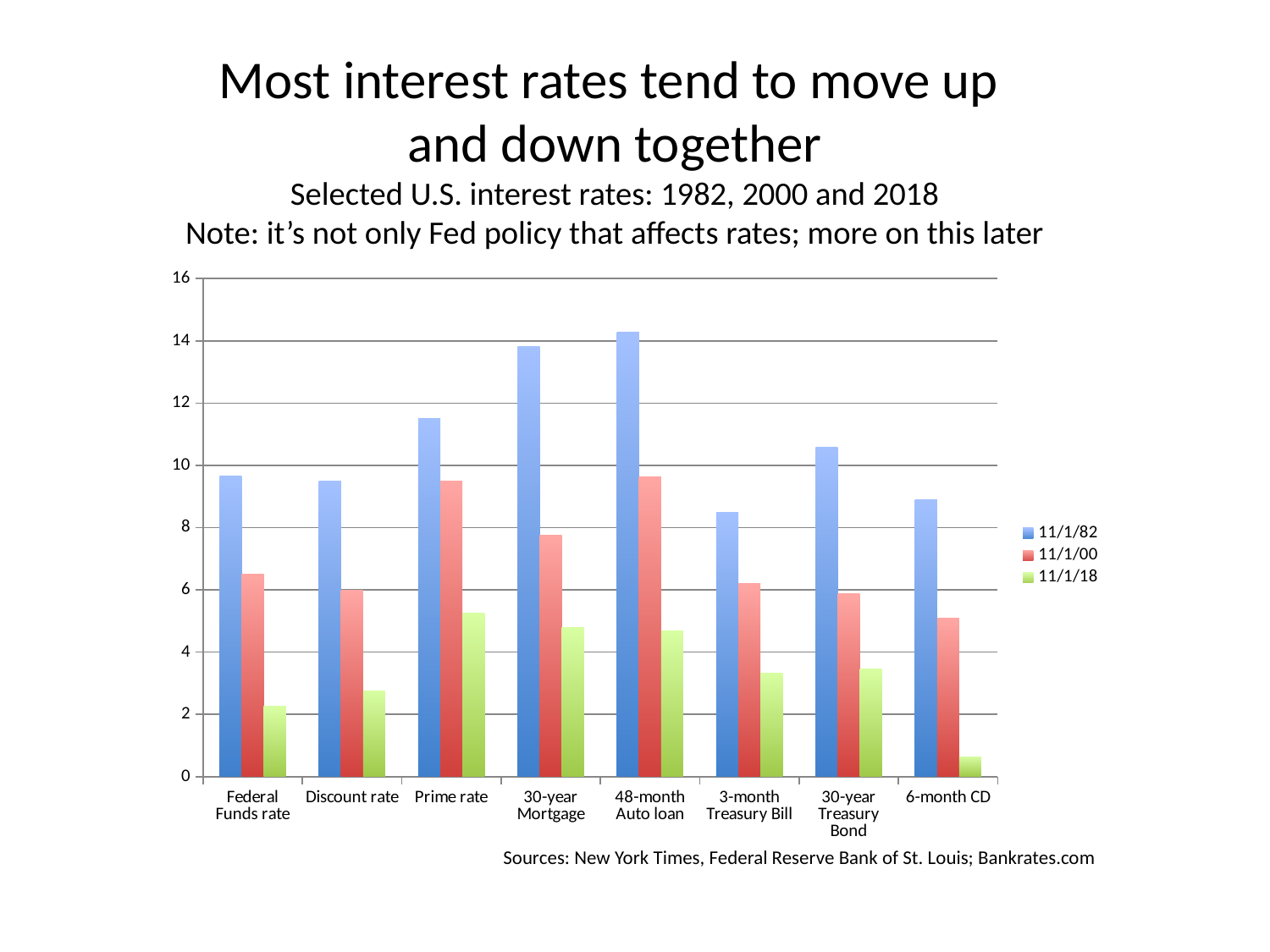
For the 11/1/82 series, which is larger: Prime rate or Discount rate? Prime rate Which category has the highest value for the 11/1/18 series? Prime rate Is the 11/1/82 value for 30-year Treasury Bond greater or less than 10? greater How many interest rate categories are shown on the x axis? 8 Which category has the lowest value for the 11/1/18 series? 6-month CD Is the 11/1/18 value for 6-month CD greater or less than 2? less What are the three dates listed in the legend? 11/1/82, 11/1/00, 11/1/18 Is the 11/1/82 value for 30-year Mortgage greater or less than 12? greater What kind of chart is shown on the slide? bar chart How many series does the legend list? 3 Which category has the highest value for the 11/1/82 series? 48-month Auto loan